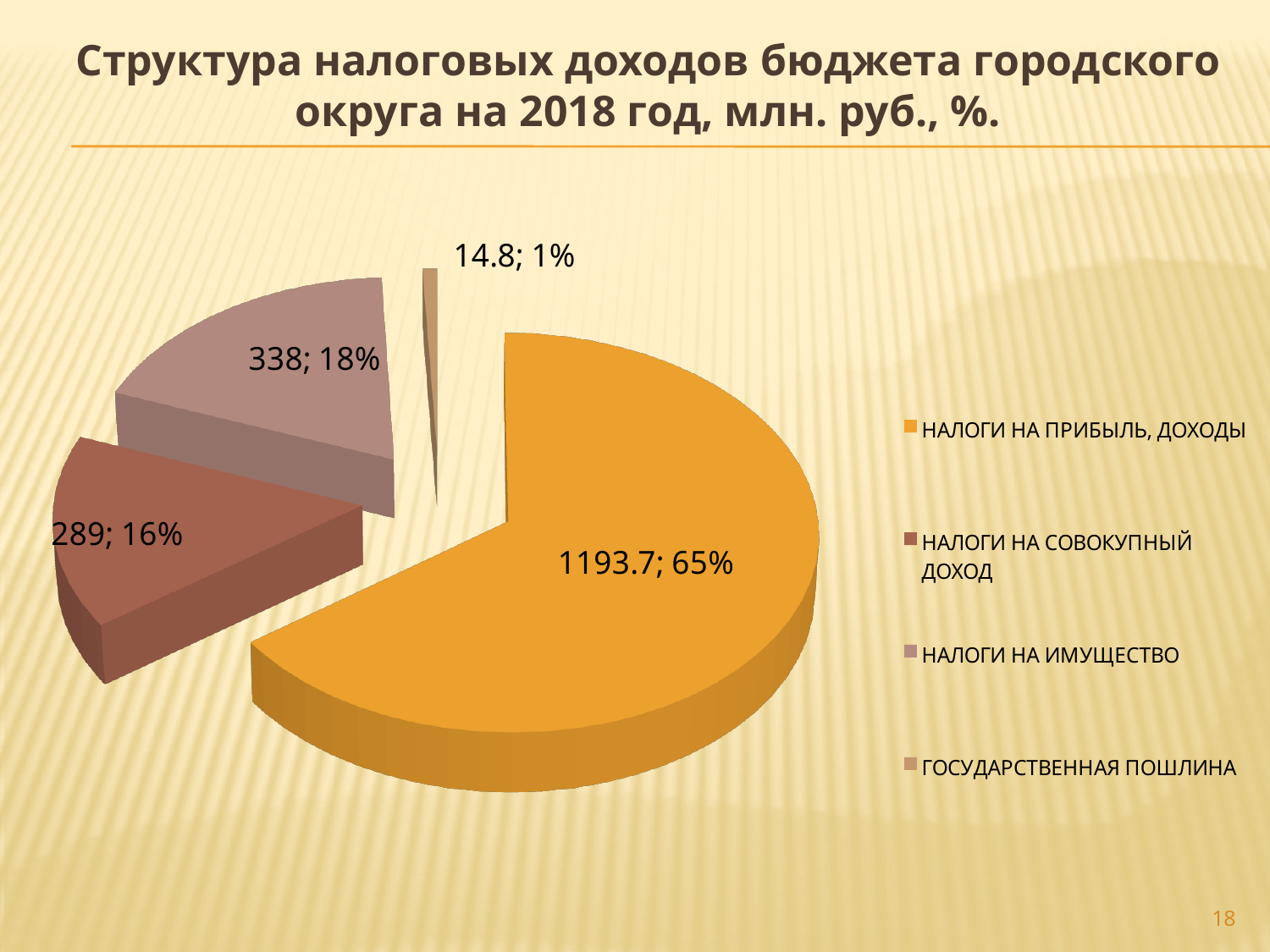
What is the difference between the values for НАЛОГИ НА ИМУЩЕСТВО and НАЛОГИ НА СОВОКУПНЫЙ ДОХОД? 49 What is the value for ГОСУДАРСТВЕННАЯ ПОШЛИНА? 14.8 How many categories does the legend list? 4 Which is larger: НАЛОГИ НА ИМУЩЕСТВО or НАЛОГИ НА СОВОКУПНЫЙ ДОХОД? НАЛОГИ НА ИМУЩЕСТВО What share of the pie does НАЛОГИ НА ИМУЩЕСТВО represent? 18% Which category has the smallest slice? ГОСУДАРСТВЕННАЯ ПОШЛИНА What share of the pie does НАЛОГИ НА ПРИБЫЛЬ, ДОХОДЫ represent? 65% What is the value for НАЛОГИ НА ПРИБЫЛЬ, ДОХОДЫ? 1193.7 What is the value for НАЛОГИ НА ИМУЩЕСТВО? 338 Which category has the largest slice? НАЛОГИ НА ПРИБЫЛЬ, ДОХОДЫ What is the value for НАЛОГИ НА СОВОКУПНЫЙ ДОХОД? 289 What type of chart is shown on the slide? Pie chart